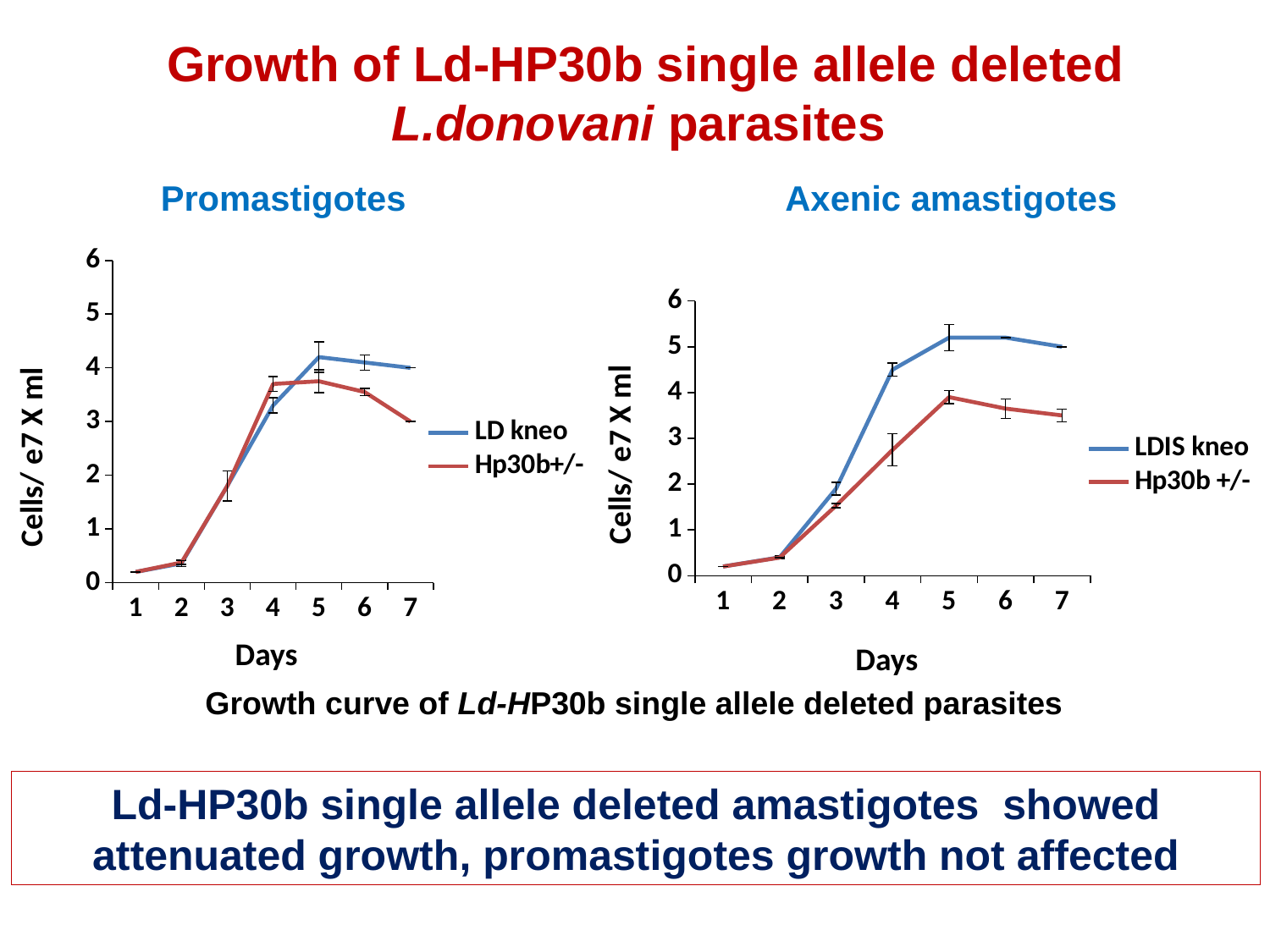
In the Axenic amastigotes chart, does the LDIS kneo series rise or fall from day 1 to day 5? rise What colour is the Hp30b +/- line in the Axenic amastigotes chart? red How many days are plotted on the x axis of the Promastigotes chart? 7 What kind of chart is the Promastigotes chart? line chart In the Axenic amastigotes chart, is the value for LDIS kneo on day 4 greater or less than 4? greater In the Promastigotes chart, which series has the higher value on day 7, LD kneo or Hp30b+/-? LD kneo In the Promastigotes chart, is the value for Hp30b+/- on day 2 greater or less than 1? less What is the y-axis label of the Promastigotes chart? Cells/ e7 X ml In the Axenic amastigotes chart, which series has the higher value on day 5, LDIS kneo or Hp30b +/-? LDIS kneo In the Axenic amastigotes chart, is the value for Hp30b +/- on day 7 greater or less than 3? greater How many series does the legend of the Axenic amastigotes chart list? 2